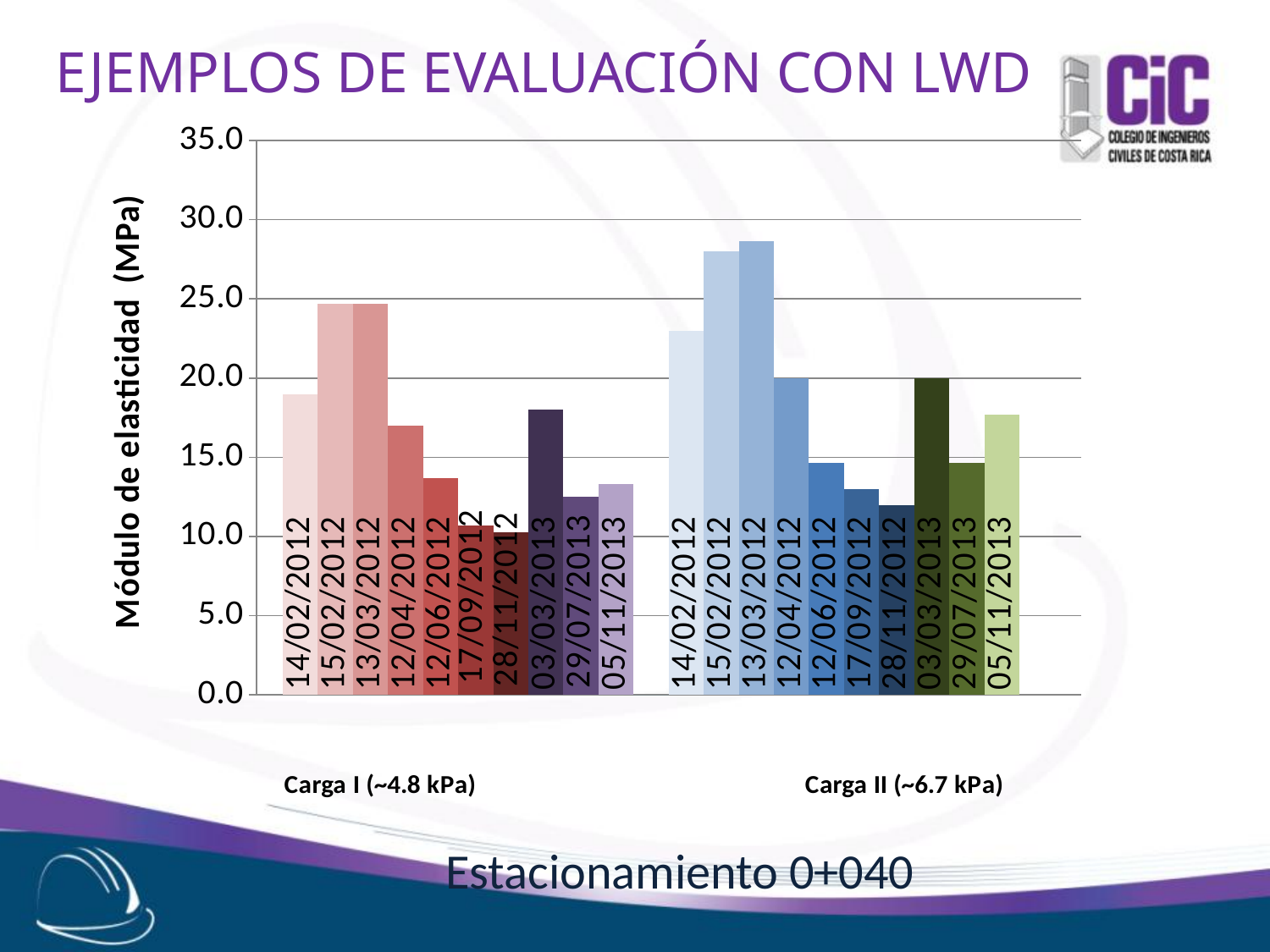
Which is larger: the value for 14/02/2012 under Carga I (~4.8 kPa) or under Carga II (~6.7 kPa)? Carga II (~6.7 kPa) Which date has the highest bar in the Carga II (~6.7 kPa) group? 13/03/2012 How many bars are plotted in total across both load groups? 20 Is the value for 13/03/2012 in the Carga II (~6.7 kPa) group greater or less than 25.0? greater Is the value for 14/02/2012 in the Carga II (~6.7 kPa) group greater or less than 20.0? greater Is the value for 12/06/2012 in the Carga I (~4.8 kPa) group greater or less than 15.0? less What are the two load groups labelled below the chart? Carga I (~4.8 kPa) and Carga II (~6.7 kPa) What is the title of the vertical axis of the chart? Módulo de elasticidad (MPa) Which date has the lowest bar in the Carga II (~6.7 kPa) group? 28/11/2012 Which is larger in the Carga I (~4.8 kPa) group: the value for 03/03/2013 or for 29/07/2013? 03/03/2013 What kind of chart is shown on the slide? bar chart How many dates (bars) are plotted in the Carga I (~4.8 kPa) group? 10